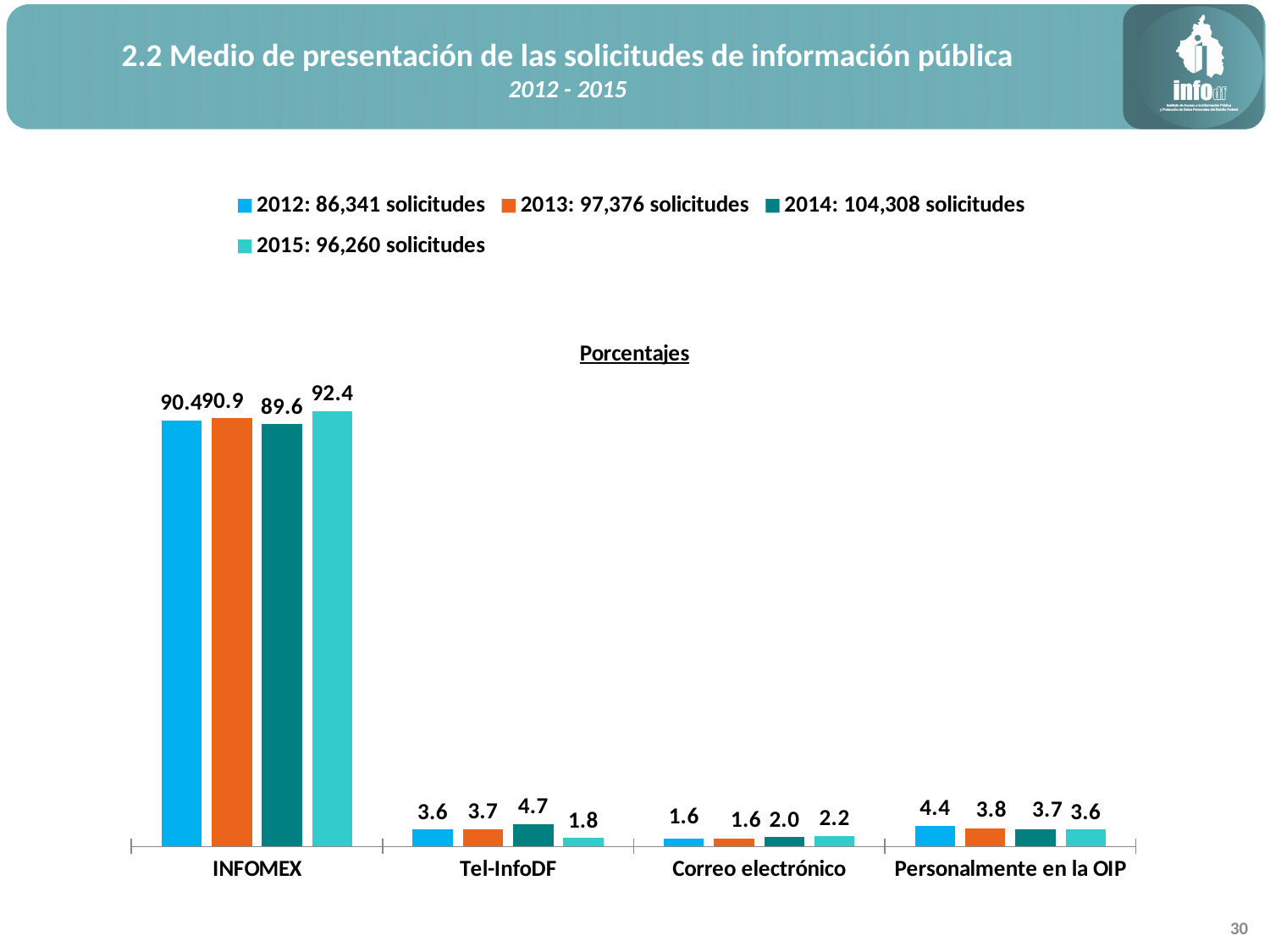
Which category has the lowest value in the 2015 series? Tel-InfoDF How many categories are shown on the x axis of the chart? 4 According to the legend, how many solicitudes were there in 2014? 104,308 What is the value for Personalmente en la OIP in the 2013 series? 3.8 Which category has the highest value in the 2014 series? INFOMEX What is the value for Tel-InfoDF in the 2014 series? 4.7 Which is larger for Tel-InfoDF: the 2014 value or the 2015 value? 2014 What kind of chart is shown on the slide? bar chart What is the value for INFOMEX in the 2015 series? 92.4 What is the value for Correo electrónico in the 2012 series? 1.6 What is the difference between the 2015 and 2014 values for INFOMEX? 2.8 How many series does the legend list? 4